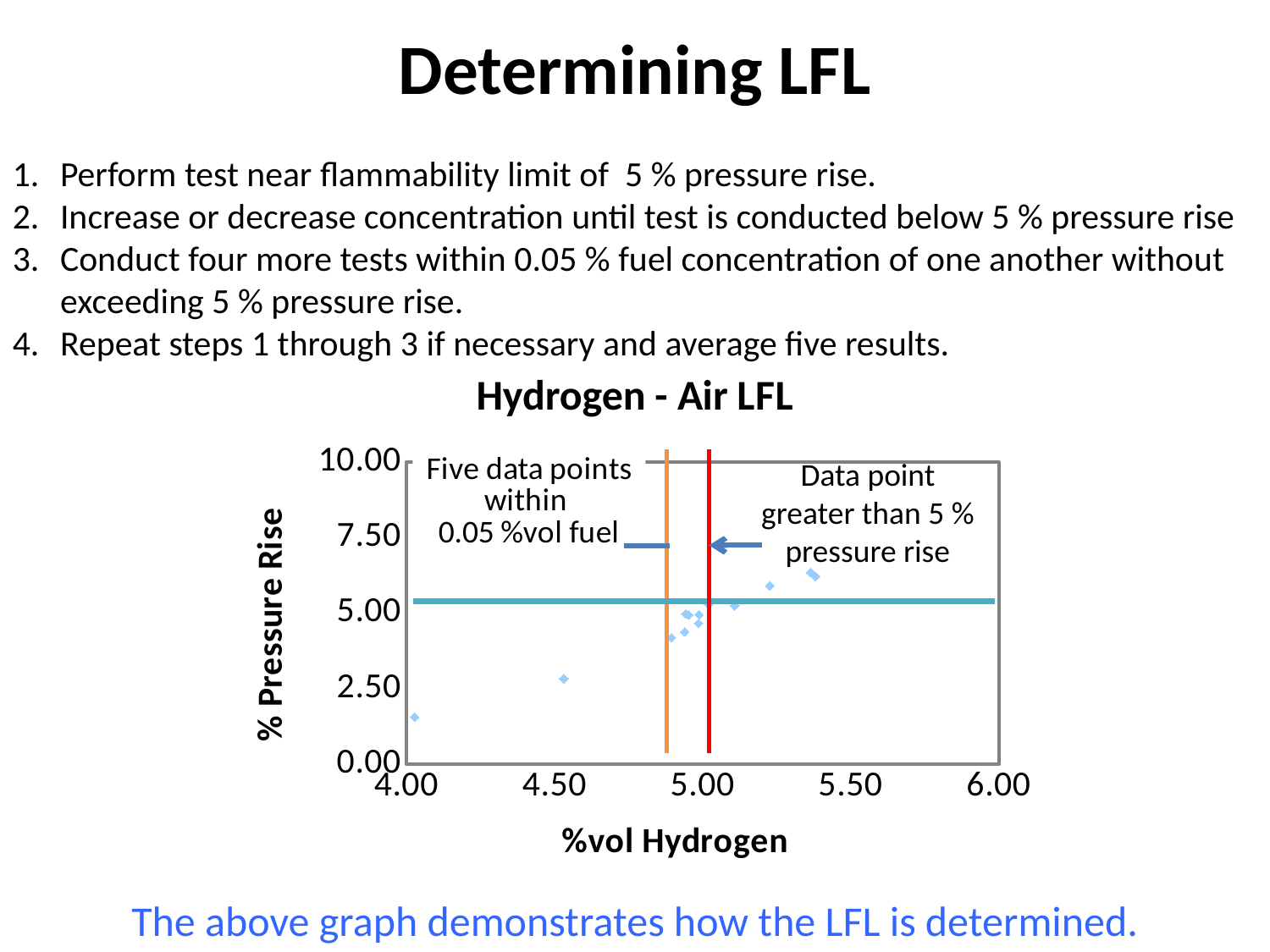
Which data point has the lowest % pressure rise: the one near 4.00 %vol hydrogen or the one near 4.50 %vol hydrogen? The one near 4.00 %vol hydrogen What kind of chart is shown on the slide? Scatter chart What is the label of the x axis of the chart? %vol Hydrogen Which data point has the lowest % pressure rise on the chart? The leftmost point, near 4.00 %vol hydrogen Is the % pressure rise for the rightmost data point (near 5.40 %vol hydrogen) greater or less than 7.50? less Is the % pressure rise for the data point at about 4.00 %vol hydrogen greater or less than 2.50? less What is the maximum value shown on the y axis of the chart? 10.00 Is the % pressure rise for the data point at about 4.50 %vol hydrogen greater or less than 5.00? less What is the title of the chart? Hydrogen - Air LFL Do the % pressure rise values generally rise or fall as %vol hydrogen increases? Rise